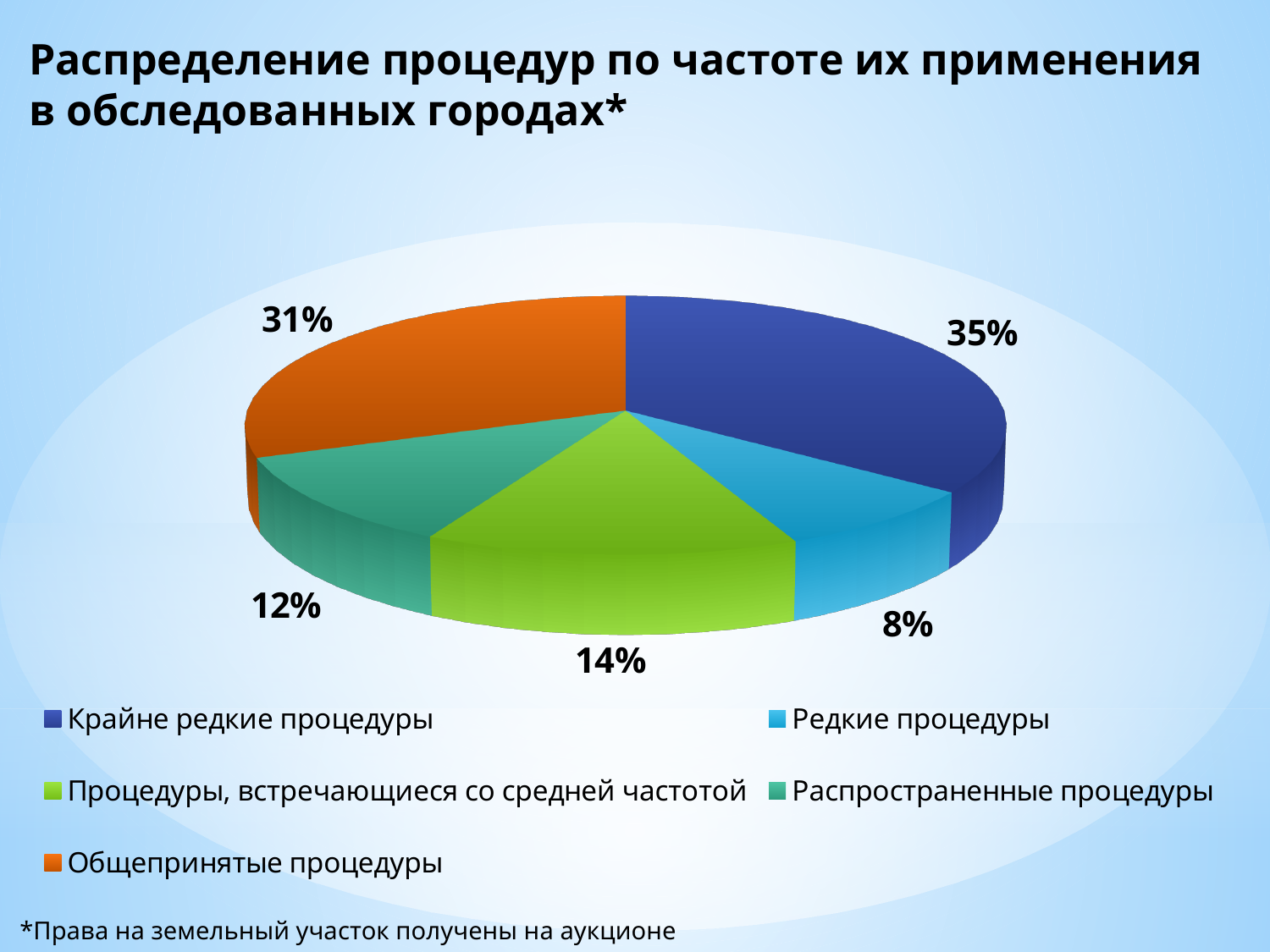
What share of the pie is labelled for "Распространенные процедуры"? 12% What share of the pie is labelled for "Редкие процедуры"? 8% What share of the pie is labelled for "Общепринятые процедуры"? 31% Which category has the largest slice of the pie? Крайне редкие процедуры What share of the pie is labelled for "Крайне редкие процедуры"? 35% Which category has the smallest slice of the pie? Редкие процедуры What share of the pie is labelled for "Процедуры, встречающиеся со средней частотой"? 14% What is the difference in percentage points between "Крайне редкие процедуры" and "Общепринятые процедуры"? 4 percentage points How many slices does the pie chart have? 5 What kind of chart is shown on the slide? Pie chart Which is larger: the slice for "Процедуры, встречающиеся со средней частотой" or the slice for "Распространенные процедуры"? Процедуры, встречающиеся со средней частотой What colour is the slice for "Общепринятые процедуры"? Orange